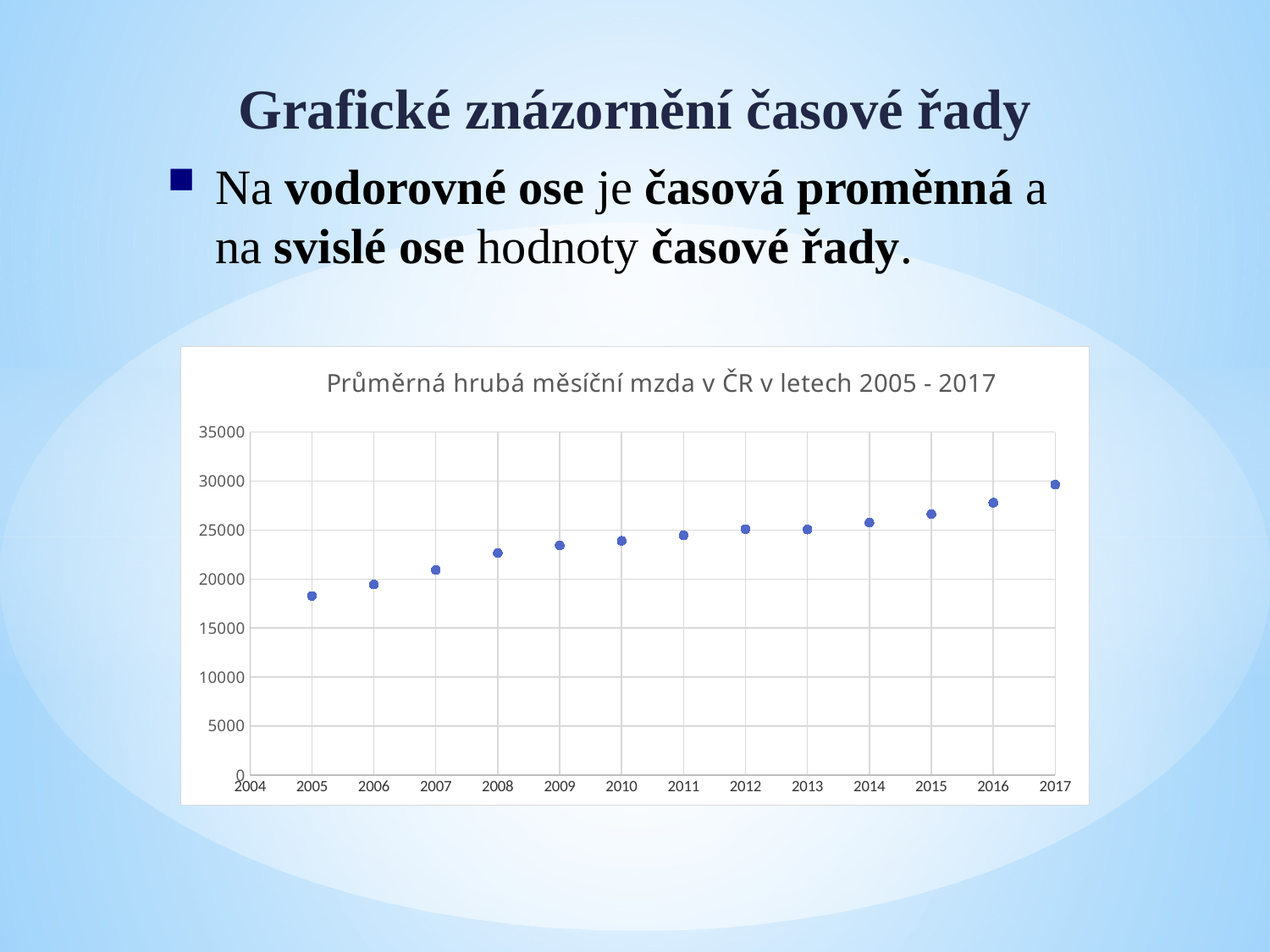
Is the value for 2017 greater or less than 25000? greater How many data points are plotted in the chart? 13 Is the value for 2010 greater or less than 25000? less What is the highest value shown on the vertical axis? 35000 Which is larger, the value for 2007 or the value for 2016? 2016 Is the value for 2015 greater or less than 25000? greater What is the title of the chart? Průměrná hrubá měsíční mzda v ČR v letech 2005 - 2017 What kind of chart is shown on the slide? scatter chart Do the values rise or fall from 2005 to 2017? rise Which year has the highest value in the chart? 2017 Which year has the lowest value in the chart? 2005